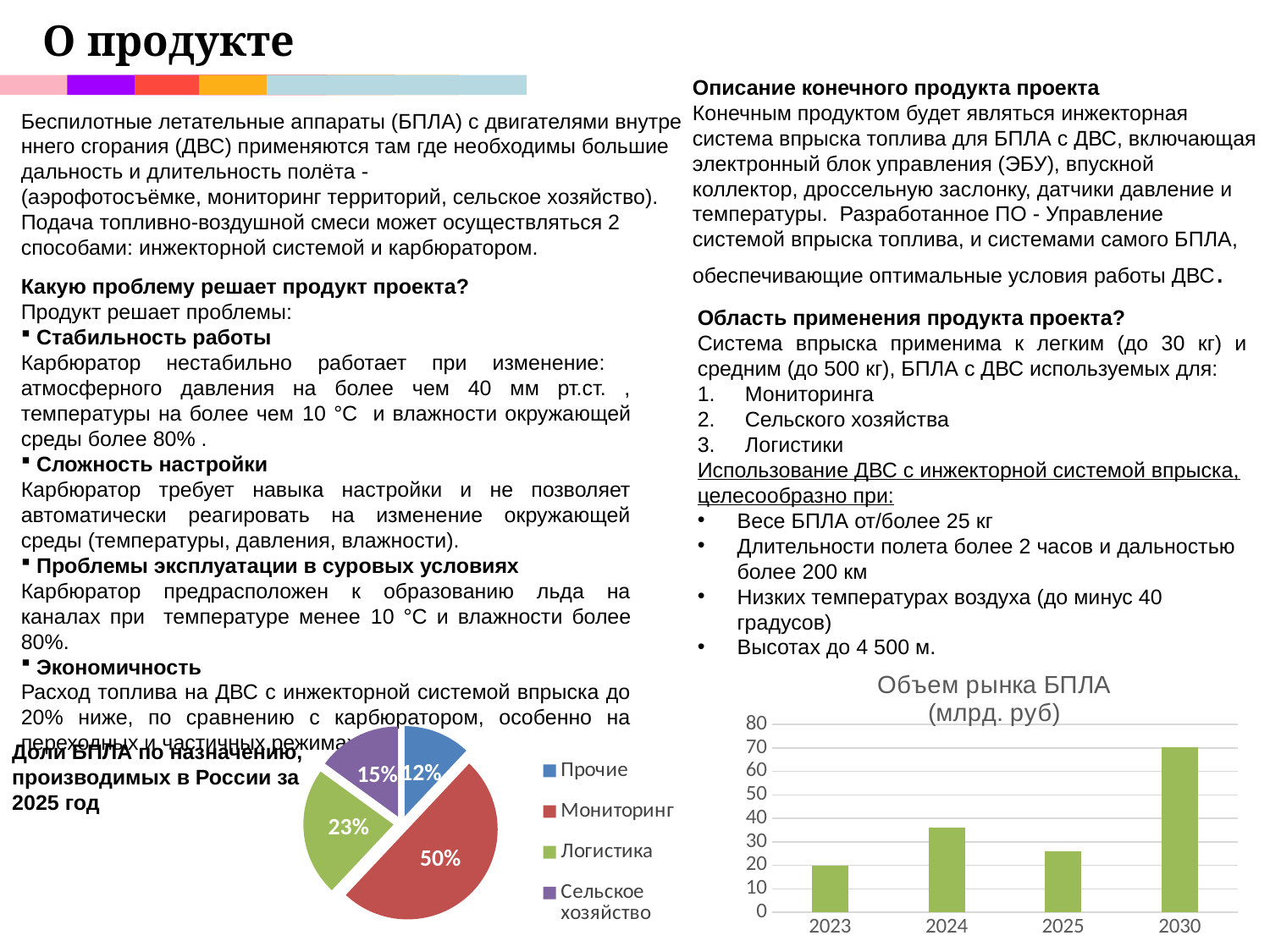
In the pie chart 'Доли БПЛА по назначению, производимых в России за 2025 год', what share does Мониторинг have? 50% In the chart 'Объем рынка БПЛА (млрд. руб)', which is larger, the value for 2024 or the value for 2025? 2024 In the pie chart 'Доли БПЛА по назначению', what is the difference between the shares of Мониторинг and Логистика? 27% In the pie chart 'Доли БПЛА по назначению', what share does Сельское хозяйство have? 15% In the pie chart 'Доли БПЛА по назначению', which category has the smallest share? Прочие In the pie chart 'Доли БПЛА по назначению', what share does Логистика have? 23% In the pie chart 'Доли БПЛА по назначению', how many categories does the legend list? 4 In the chart 'Объем рынка БПЛА (млрд. руб)', which year has the highest value? 2030 In the pie chart 'Доли БПЛА по назначению', which category has the largest share? Мониторинг In the chart 'Объем рынка БПЛА (млрд. руб)', is the value for 2030 greater or less than 60? greater In the pie chart 'Доли БПЛА по назначению', which colour represents Логистика? Green What kind of chart is 'Объем рынка БПЛА (млрд. руб)'? Bar chart